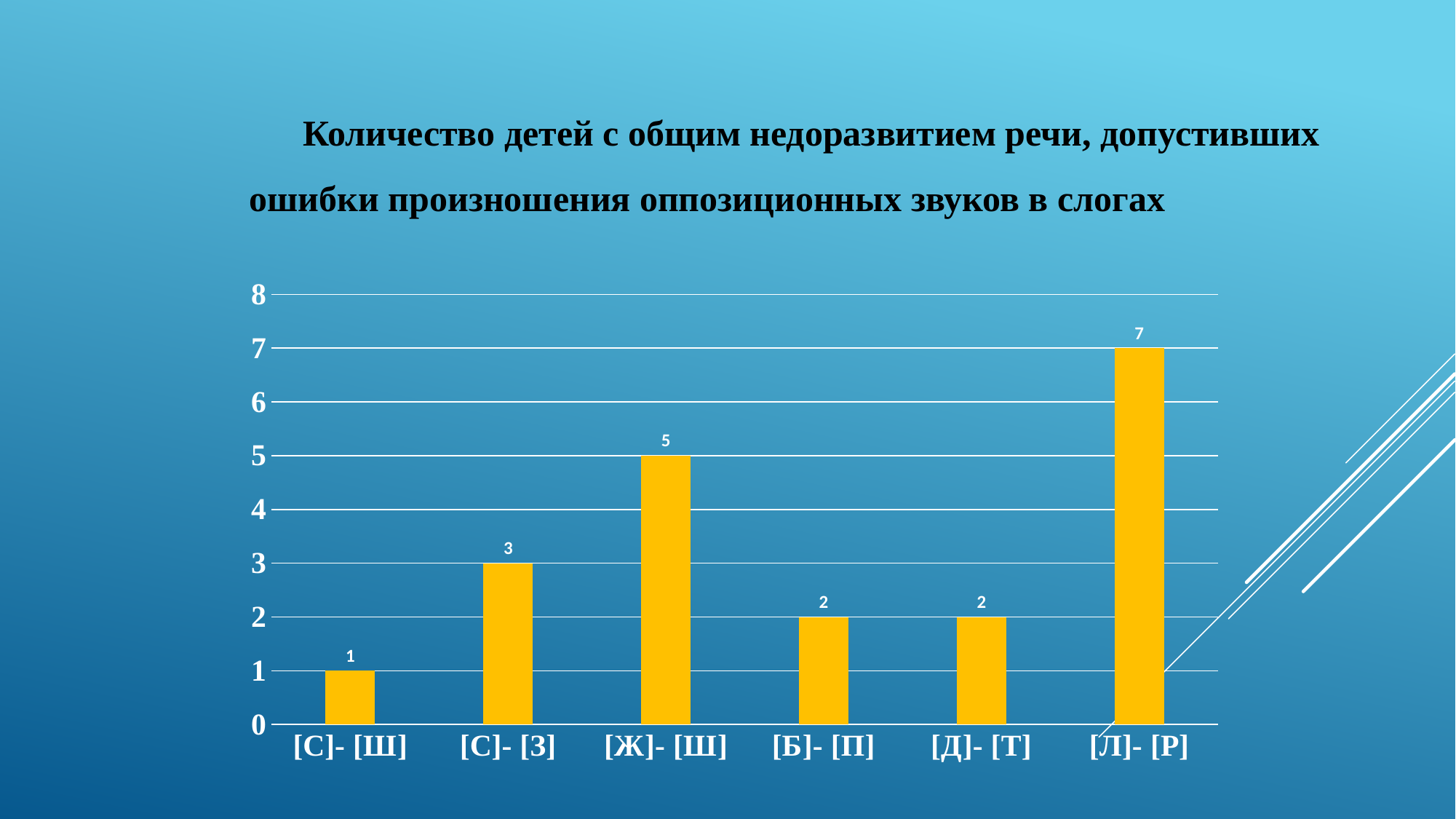
Which is larger, the value for [С]- [З] or the value for [Б]- [П]? [С]- [З] What is the value for [Ж]- [Ш]? 5 How many categories are shown on the x axis? 6 What is the value for [Л]- [Р]? 7 What kind of chart is shown on the slide? bar chart What is the value for [С]- [Ш]? 1 What is the value for [С]- [З]? 3 Which category has the lowest value? [С]- [Ш] What is the difference between the values for [Л]- [Р] and [Ж]- [Ш]? 2 Is the value for [Л]- [Р] greater or less than 6? greater What colour are the bars in the chart? yellow Which category has the highest value? [Л]- [Р]